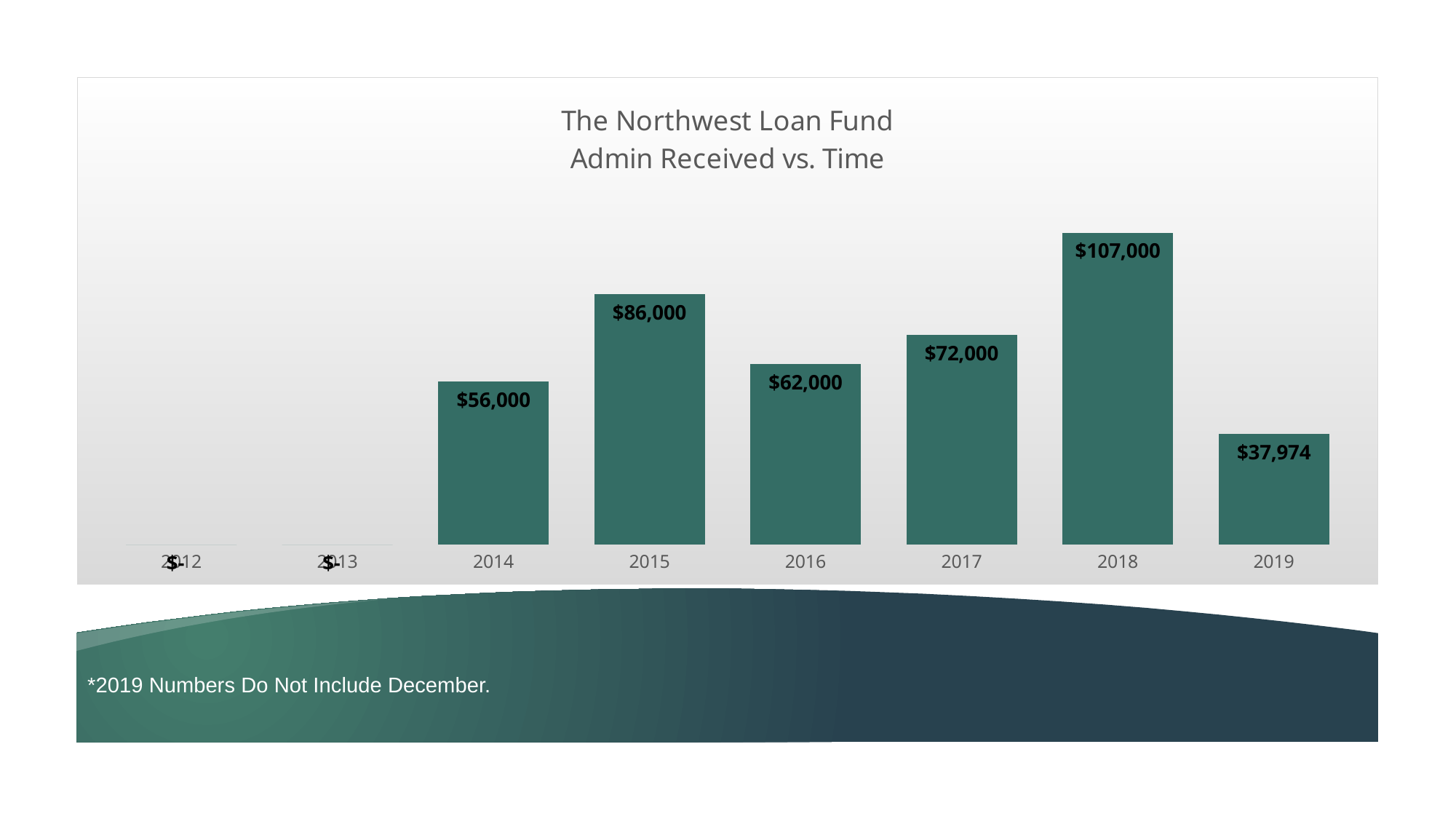
How many years are shown on the x axis of the chart? 8 Did the admin received rise or fall from 2018 to 2019? Fall What was the admin received in 2019? $37,974 What type of chart is shown on the slide? Bar chart What is the difference between the admin received in 2017 and in 2016? $10,000 Which year had the highest admin received? 2018 Which year had a larger admin received, 2016 or 2017? 2017 What is the difference between the admin received in 2018 and in 2015? $21,000 What is the title of the chart? The Northwest Loan Fund Admin Received vs. Time What was the admin received in 2018? $107,000 What was the admin received in 2014? $56,000 According to the footnote, what do the 2019 numbers not include? December